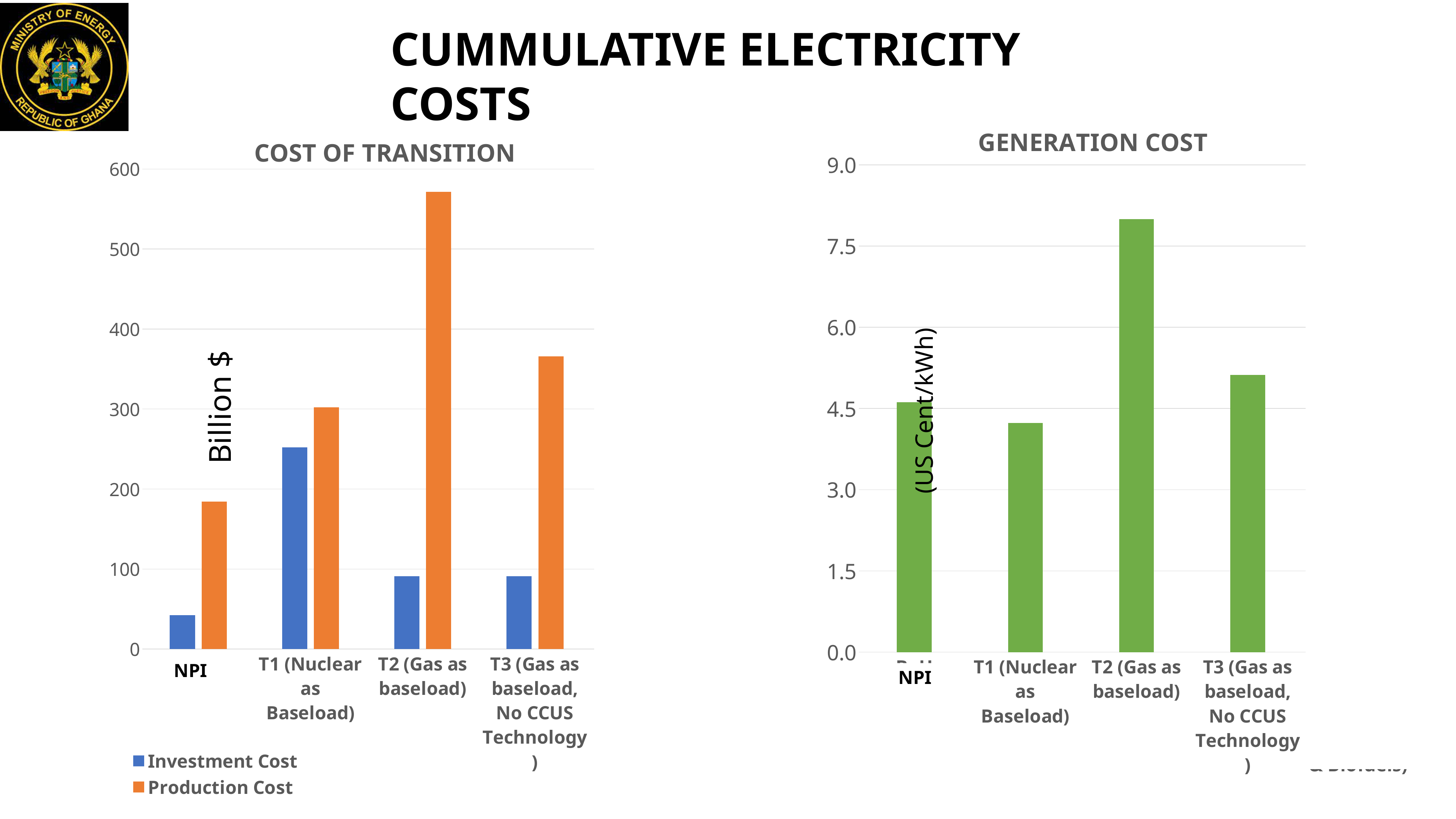
In the COST OF TRANSITION chart, which category has the highest Production Cost? T2 (Gas as baseload) In the COST OF TRANSITION chart, how many categories are shown on the x axis? 4 In the COST OF TRANSITION chart, which category has the highest Investment Cost? T1 (Nuclear as Baseload) In the COST OF TRANSITION chart, what kind of chart is used? bar chart In the GENERATION COST chart, is the value for T2 (Gas as baseload) greater or less than 7.5? greater In the GENERATION COST chart, what unit is shown on the vertical axis label? (US Cent/kWh) In the GENERATION COST chart, which category has the highest value? T2 (Gas as baseload) In the GENERATION COST chart, which category has the lowest value? T1 (Nuclear as Baseload) In the COST OF TRANSITION chart, is the Investment Cost for NPI greater or less than 100? less In the COST OF TRANSITION chart, is the Production Cost for T2 (Gas as baseload) greater or less than 500? greater In the COST OF TRANSITION chart, which is larger: the Production Cost for T1 (Nuclear as Baseload) or for T3 (Gas as baseload, No CCUS Technology)? T3 (Gas as baseload, No CCUS Technology) In the COST OF TRANSITION chart, how many series does the legend list? 2